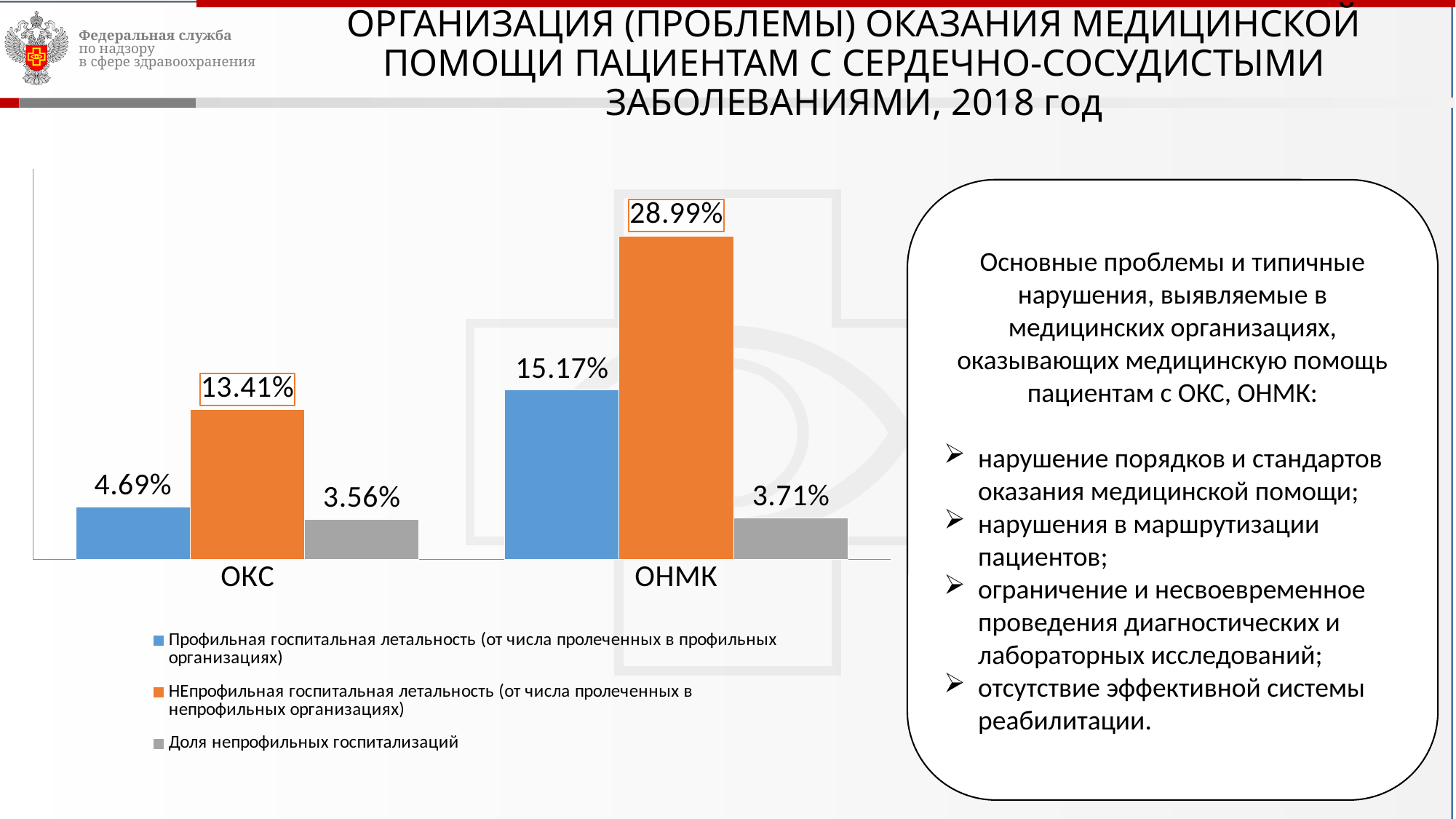
What colour are the bars for НЕпрофильная госпитальная летальность? Orange Which category has the highest value for Профильная госпитальная летальность? ОНМК What kind of chart is shown on the slide? Bar chart What is the value of Профильная госпитальная летальность for ОКС? 4.69% Which series has the lowest value for ОКС? Доля непрофильных госпитализаций What is the value of Доля непрофильных госпитализаций for ОНМК? 3.71% What is the difference between НЕпрофильная госпитальная летальность and Профильная госпитальная летальность for ОНМК? 13.82% What is the value of НЕпрофильная госпитальная летальность for ОНМК? 28.99% What is the value of НЕпрофильная госпитальная летальность for ОКС? 13.41% How many series does the legend list? 3 How many categories are shown on the x axis of the chart? 2 Which is larger: Профильная госпитальная летальность for ОНМК or НЕпрофильная госпитальная летальность for ОКС? Профильная госпитальная летальность for ОНМК